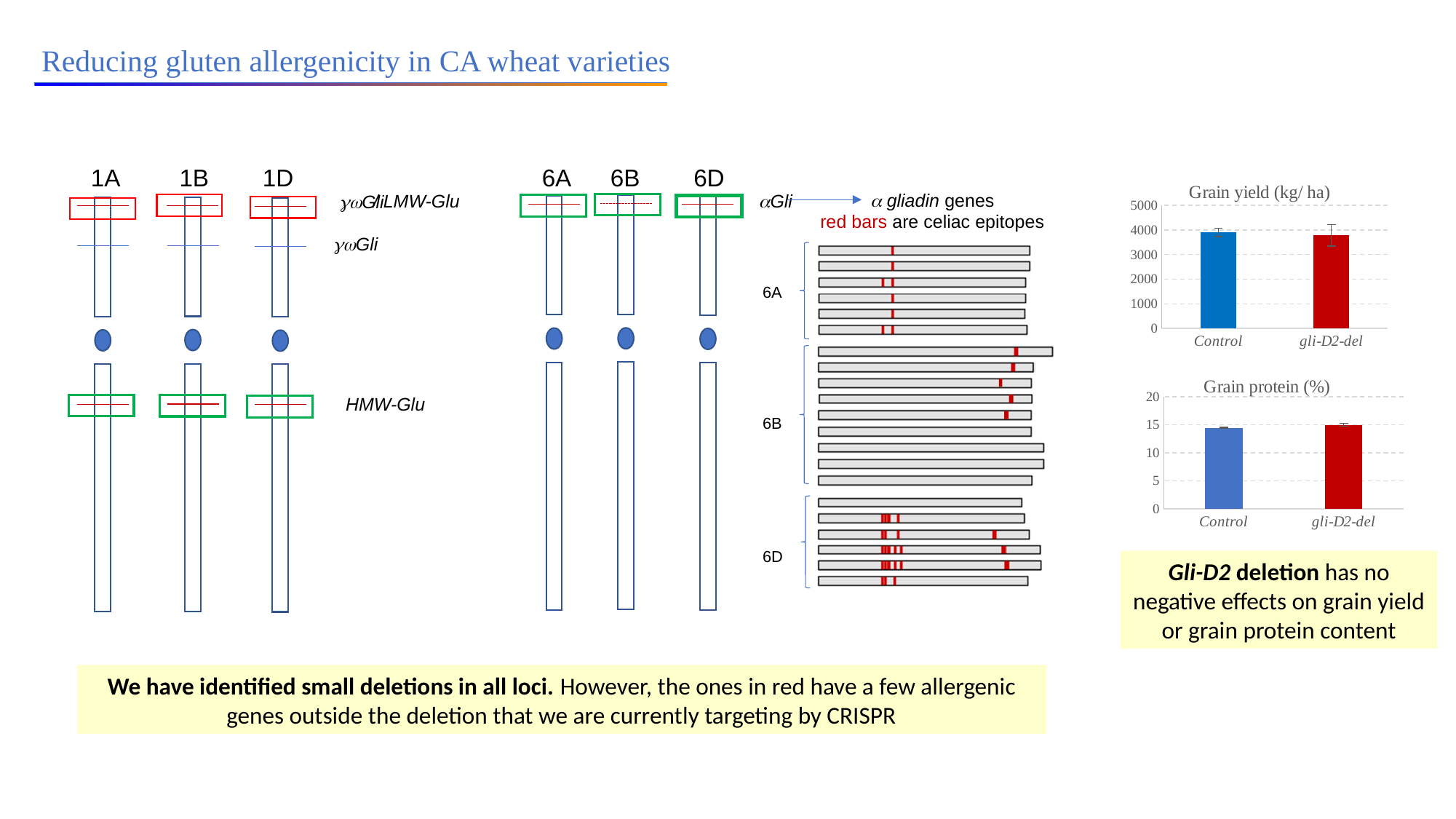
In the Grain yield (kg/ ha) chart, is the value for Control greater or less than 3000? greater What type of chart is the Grain yield (kg/ ha) chart? bar chart In the Grain protein (%) chart, is the value for gli-D2-del greater or less than 20? less In the Grain protein (%) chart, is the value for Control greater or less than 10? greater What type of chart is the Grain protein (%) chart? bar chart How many categories are shown on the x axis of the Grain yield (kg/ ha) chart? 2 How many categories are shown on the x axis of the Grain protein (%) chart? 2 In the Grain protein (%) chart, what colour is the gli-D2-del bar? red What is the title of the upper chart on the right side of the slide? Grain yield (kg/ ha)